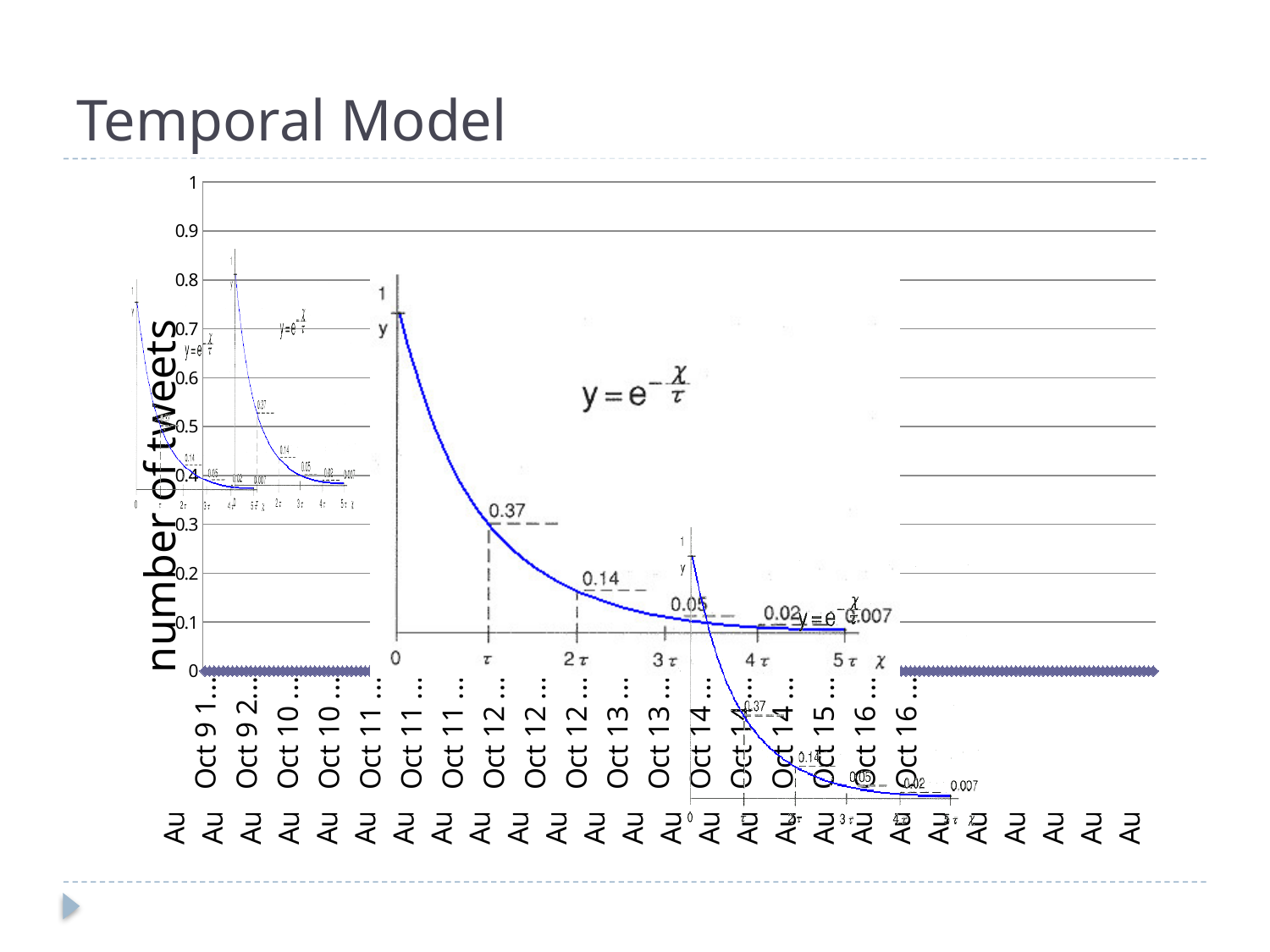
On the large overlaid decay curve, what value is marked at x = τ? 0.37 On the large overlaid decay curve, at which marked x position is the value lowest? 5τ What is the highest value shown on the chart's vertical axis? 1 On the large overlaid decay curve, what value is marked at x = 5τ? 0.007 On the large overlaid decay curve, does the value rise or fall as x increases? fall On the large overlaid decay curve, which is larger: the value at τ or the value at 3τ? the value at τ On the large overlaid decay curve, what value is marked at x = 4τ? 0.02 What is the label on the vertical axis of the chart? number of tweets On the large overlaid decay curve, what value is marked at x = 2τ? 0.14 On the large overlaid decay curve, what value is marked at x = 3τ? 0.05 On the large overlaid decay curve, what is the difference between the values marked at τ and 2τ? 0.23 What kind of chart is the overlaid decay curve? line chart